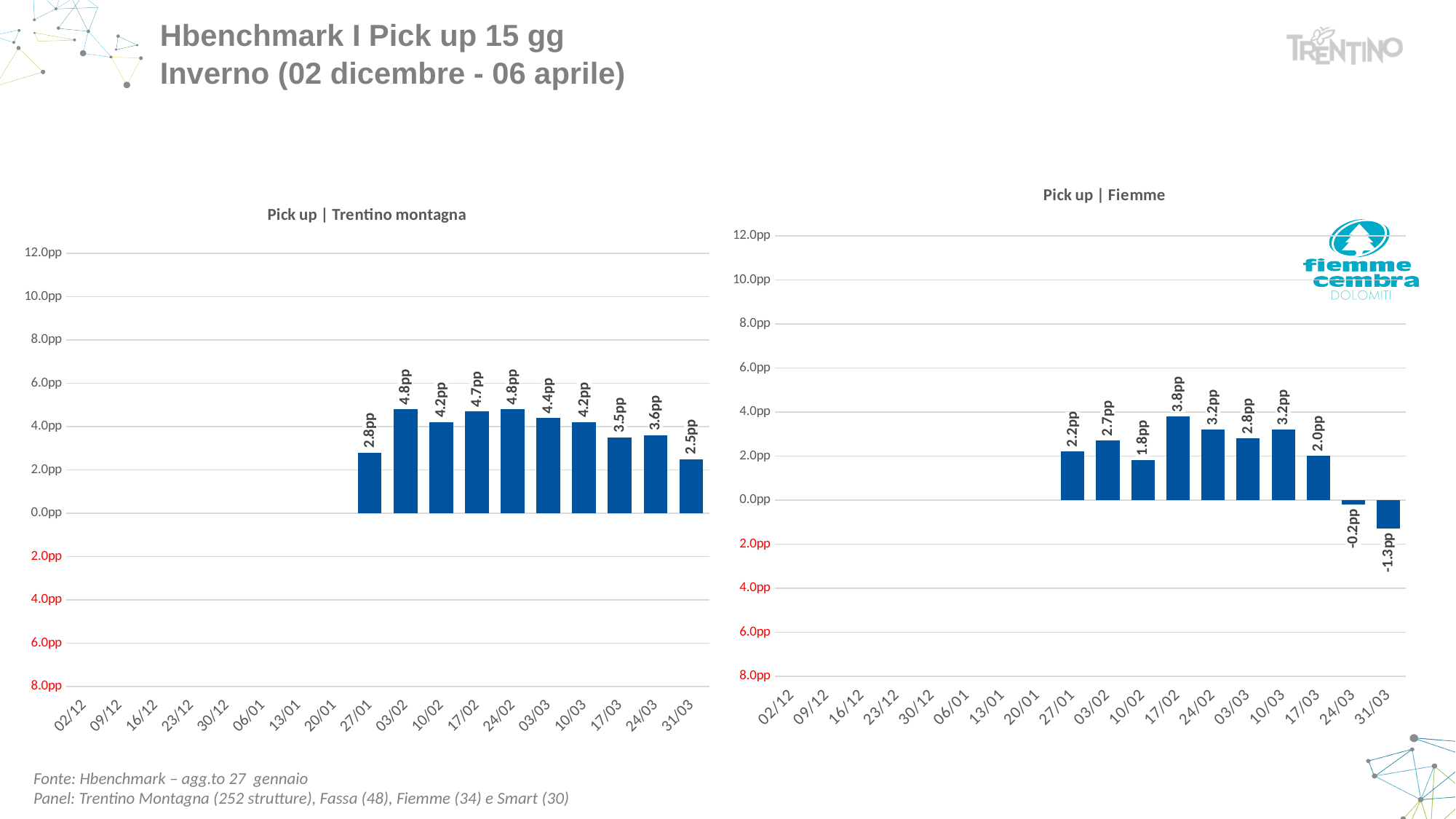
In the 'Pick up | Fiemme' chart, what is the difference between the values for 03/02 and 10/02? 0.9pp In the 'Pick up | Trentino montagna' chart, which is larger, the value for 17/03 or the value for 24/03? 24/03 What type of chart is the 'Pick up | Trentino montagna' chart? Bar chart In the 'Pick up | Trentino montagna' chart, what is the difference between the values for 17/02 and 27/01? 1.9pp In the 'Pick up | Fiemme' chart, which date has the lowest value? 31/03 In the 'Pick up | Fiemme' chart, how many bars have a data label? 10 In the 'Pick up | Fiemme' chart, which date has the highest value? 17/02 In the 'Pick up | Trentino montagna' chart, what is the value for 31/03? 2.5pp In the 'Pick up | Fiemme' chart, what is the value for 31/03? -1.3pp In the 'Pick up | Fiemme' chart, what is the value for 17/02? 3.8pp In the 'Pick up | Trentino montagna' chart, which date has the lowest value? 31/03 In the 'Pick up | Trentino montagna' chart, what is the value for 03/02? 4.8pp